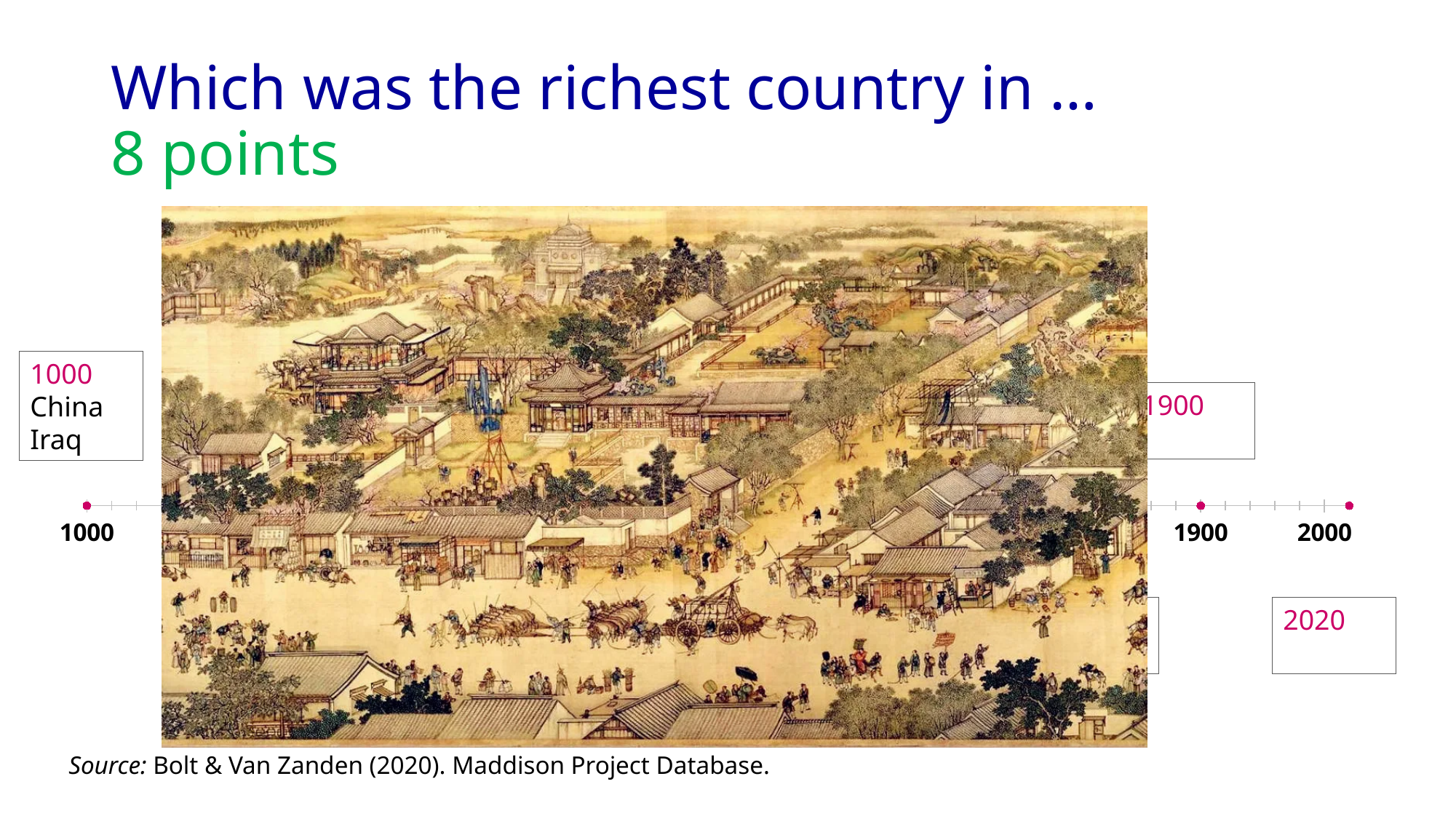
What source is cited for the timeline data on the slide? Bolt & Van Zanden (2020). Maddison Project Database. What is the earliest year labeled on the timeline axis at the bottom of the slide? 1000 What is the latest year tick label shown on the timeline axis? 2000 Which countries are listed in the box for the year 1000 on the timeline? China, Iraq Which year label on the timeline axis is further to the right, 1900 or 2000? 2000 What year is shown in the box at the far right of the timeline? 2020